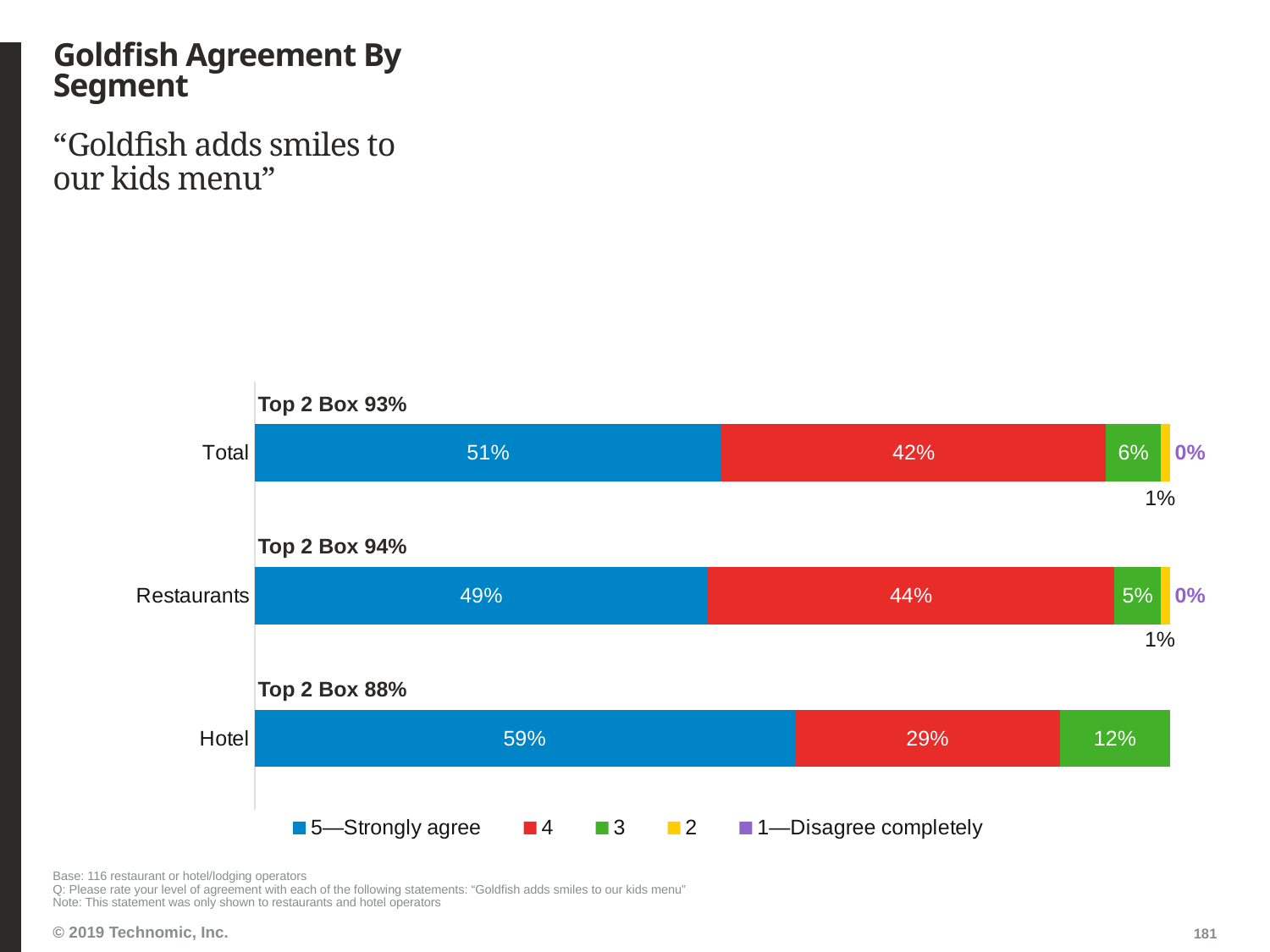
How many segments are plotted on the chart? 3 Which segment has the lowest value for 4? Hotel What percentage of Restaurants respondents answered 4? 44% What percentage of Hotel respondents answered 5—Strongly agree? 59% How many series does the legend list? 5 What is the difference between the 5—Strongly agree values for Hotel and Restaurants? 10% What is the Top 2 Box value shown for Restaurants? 94% What is the Top 2 Box value shown for Hotel? 88% What is the value for 3 in the Total bar? 6% Which is larger: the 3 value for Hotel or the 3 value for Total? Hotel What kind of chart is shown on the slide? Stacked bar chart Which segment has the highest 5—Strongly agree value? Hotel